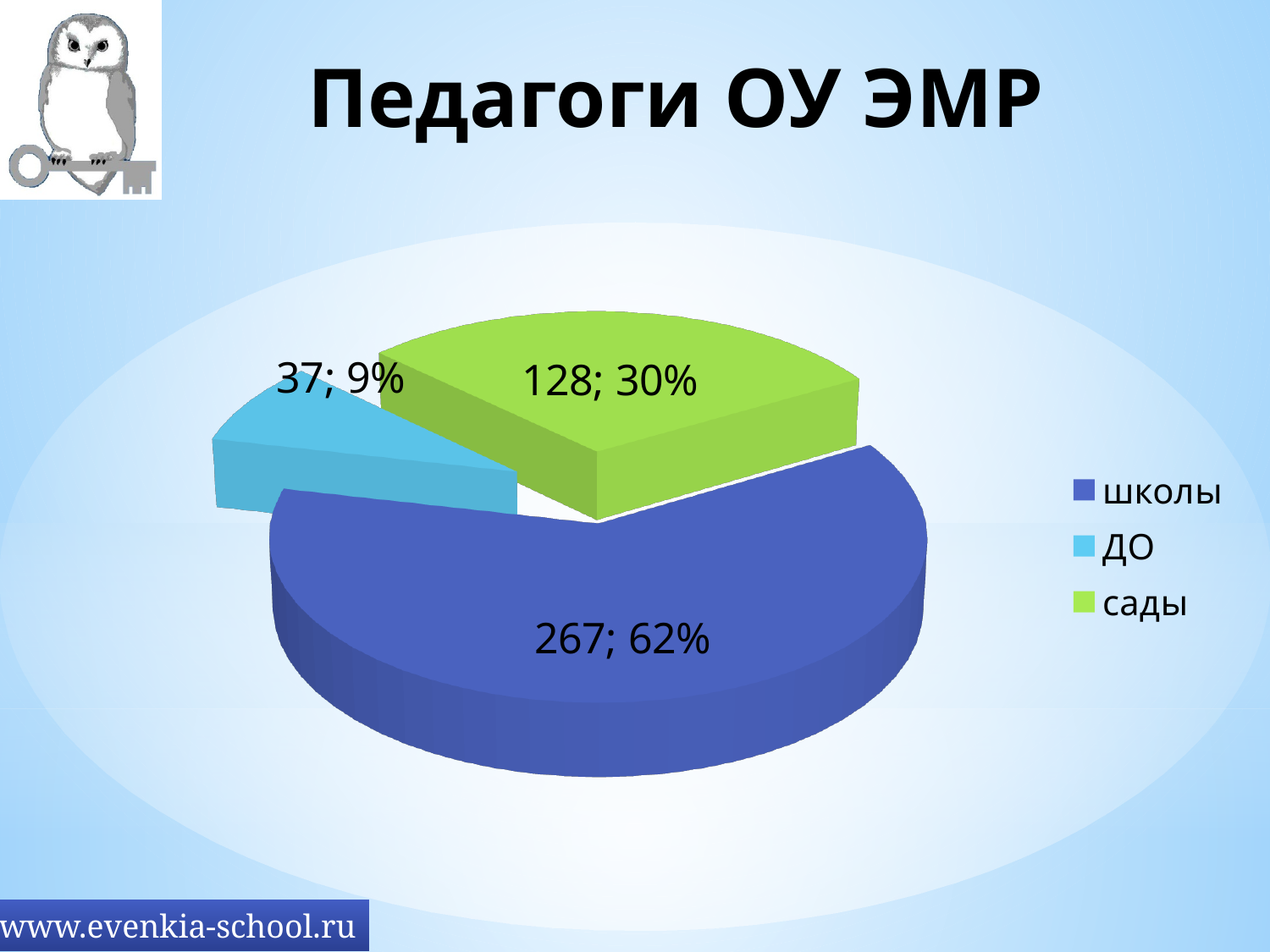
How many slices does the pie chart have? 3 What kind of chart is shown on the slide? pie chart What share of the pie does школы represent? 62% How many entries does the legend list? 3 What is the difference between the values for школы and сады? 139 What is the value for сады? 128 What is the value for ДО? 37 Which category has the largest slice? школы What is the value for школы? 267 What is the title of the chart? Педагоги ОУ ЭМР Which category has the smallest slice? ДО What share of the pie does ДО represent? 9%